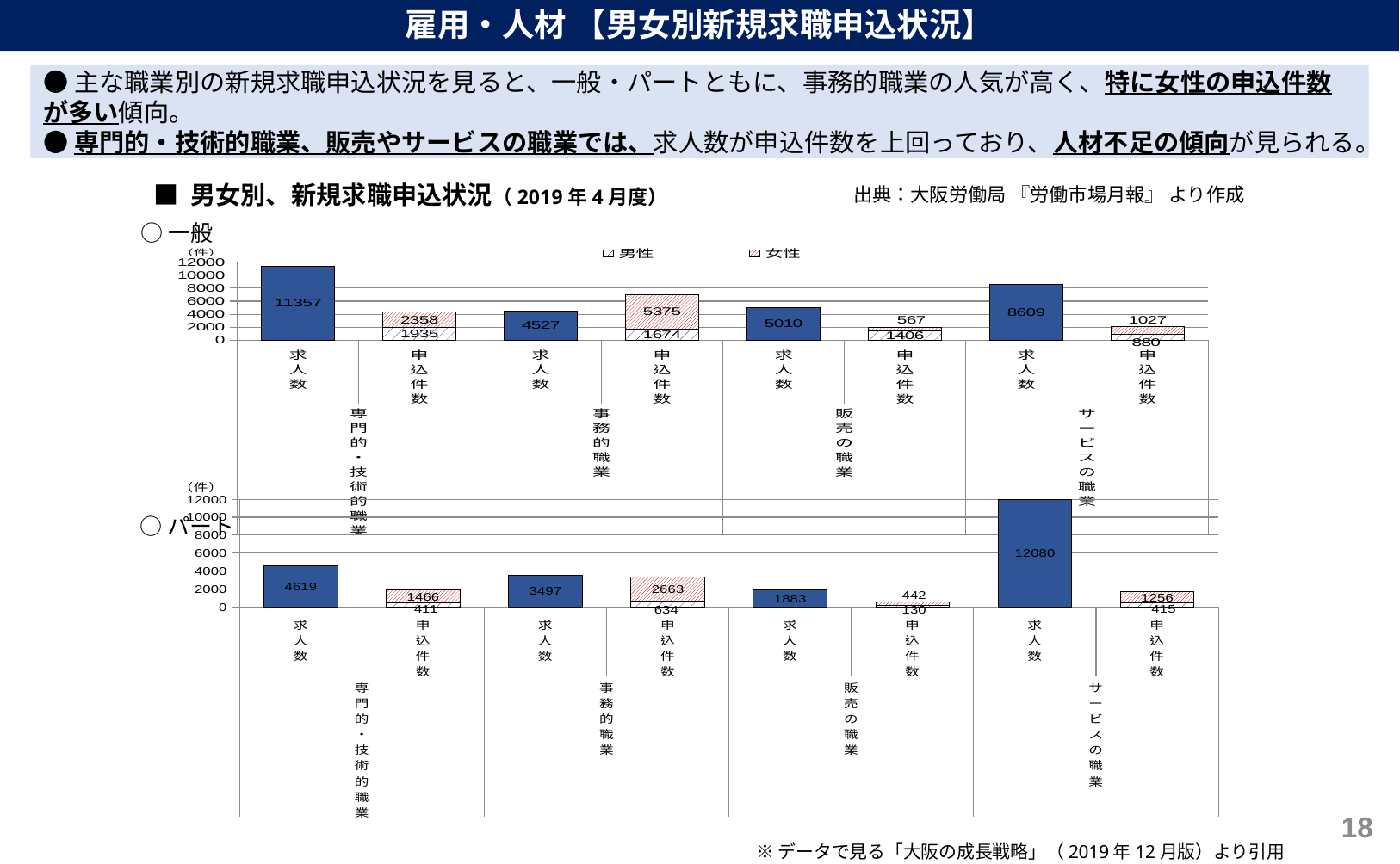
What type of chart is the bottom chart (パート)? Bar chart How many series does the legend of the top chart (一般) list? 2 In the top chart (一般), which occupation has the highest 求人数? 専門的・技術的職業 In the top chart (一般), what is the total 申込件数 (男性 plus 女性) for 事務的職業? 7049 In the top chart (一般), what is the 求人数 value for 専門的・技術的職業? 11357 In the bottom chart (パート), what is the 男性 value of 申込件数 for 販売の職業? 130 In the bottom chart (パート), which occupation has the lowest 求人数? 販売の職業 In the bottom chart (パート), what is the 求人数 value for サービスの職業? 12080 In the top chart (一般), what is the difference between 求人数 for 専門的・技術的職業 and 求人数 for サービスの職業? 2748 In the top chart (一般), what is the 女性 value of 申込件数 for 事務的職業? 5375 In the top chart (一般), which is larger for 販売の職業: the 男性 申込件数 or the 女性 申込件数? 男性 In the bottom chart (パート), what is the total 申込件数 (男性 plus 女性) for 専門的・技術的職業? 1877